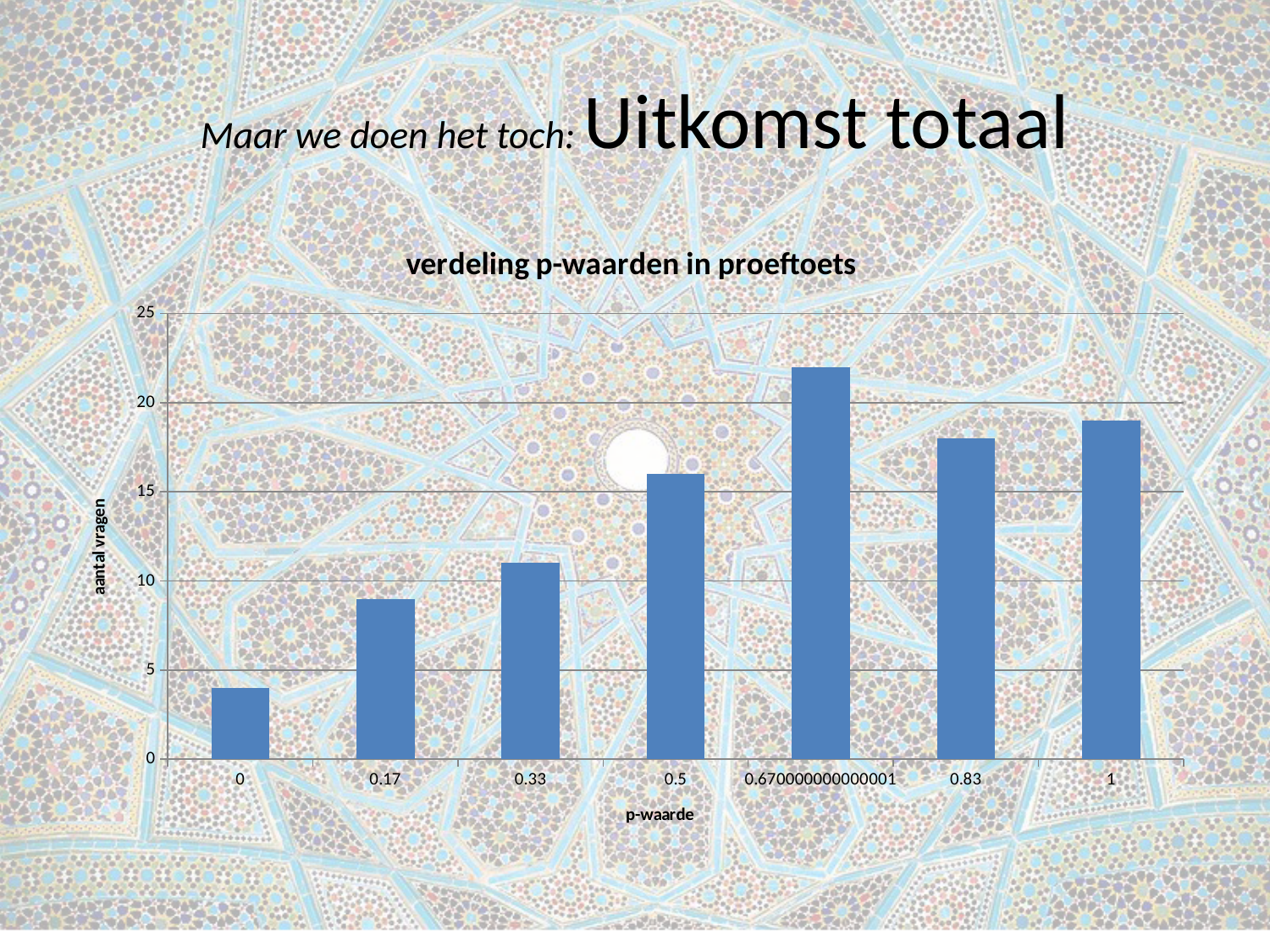
Which has the larger value: p-waarde 0.5 or p-waarde 0.83? 0.83 Is the value for p-waarde 0.17 greater or less than 5? greater Is the value for p-waarde 0.670000000000001 greater or less than 20? greater What is the title of the chart? verdeling p-waarden in proeftoets Is the value for p-waarde 0.83 greater or less than 20? less What is the label of the y axis? aantal vragen Which p-waarde category has the highest aantal vragen? 0.670000000000001 How many bars (p-waarde categories) are shown in the chart? 7 Which p-waarde category has the lowest aantal vragen? 0 What kind of chart is shown on the slide? bar chart Do the values rise or fall along the x axis from p-waarde 0 to p-waarde 0.5? rise